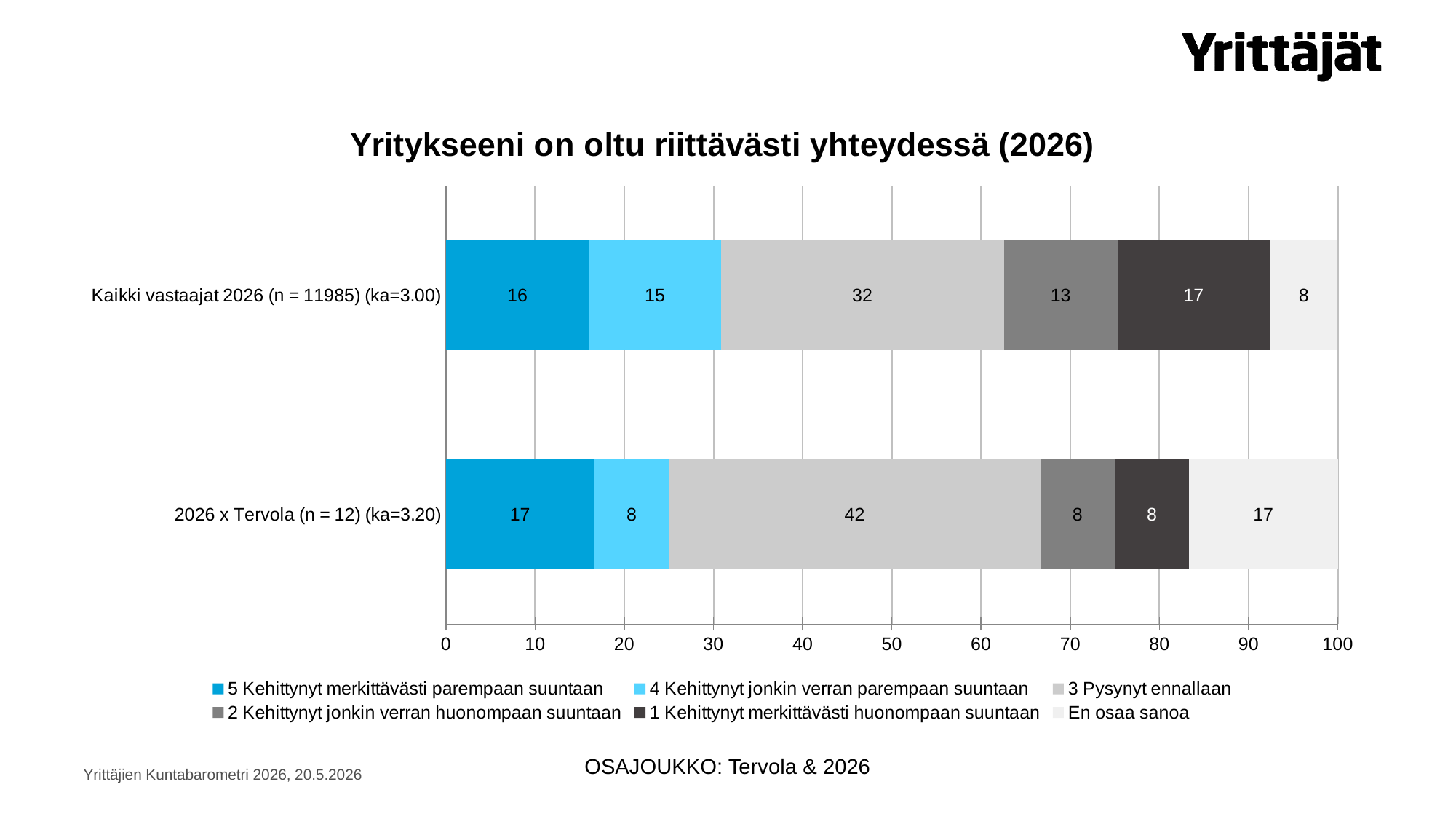
What is the title of the chart? Yritykseeni on oltu riittävästi yhteydessä (2026) What is the value of "3 Pysynyt ennallaan" for "Kaikki vastaajat 2026 (n = 11985) (ka=3.00)"? 32 Which series has the largest segment in the "2026 x Tervola (n = 12) (ka=3.20)" bar? 3 Pysynyt ennallaan What is the value of "2 Kehittynyt jonkin verran huonompaan suuntaan" for "Kaikki vastaajat 2026 (n = 11985) (ka=3.00)"? 13 How many series does the legend list? 6 What is the value of "5 Kehittynyt merkittävästi parempaan suuntaan" for "2026 x Tervola (n = 12) (ka=3.20)"? 17 What kind of chart is shown on the slide? Stacked bar chart What is the total of the stacked bar for "2026 x Tervola (n = 12) (ka=3.20)"? 100 How many categories (bars) are shown in the chart? 2 Which category has the larger value for "1 Kehittynyt merkittävästi huonompaan suuntaan": "Kaikki vastaajat 2026 (n = 11985) (ka=3.00)" or "2026 x Tervola (n = 12) (ka=3.20)"? Kaikki vastaajat 2026 (n = 11985) (ka=3.00) What is the value of "En osaa sanoa" for "2026 x Tervola (n = 12) (ka=3.20)"? 17 How much larger is the "3 Pysynyt ennallaan" value for "2026 x Tervola (n = 12) (ka=3.20)" than for "Kaikki vastaajat 2026 (n = 11985) (ka=3.00)"? 10